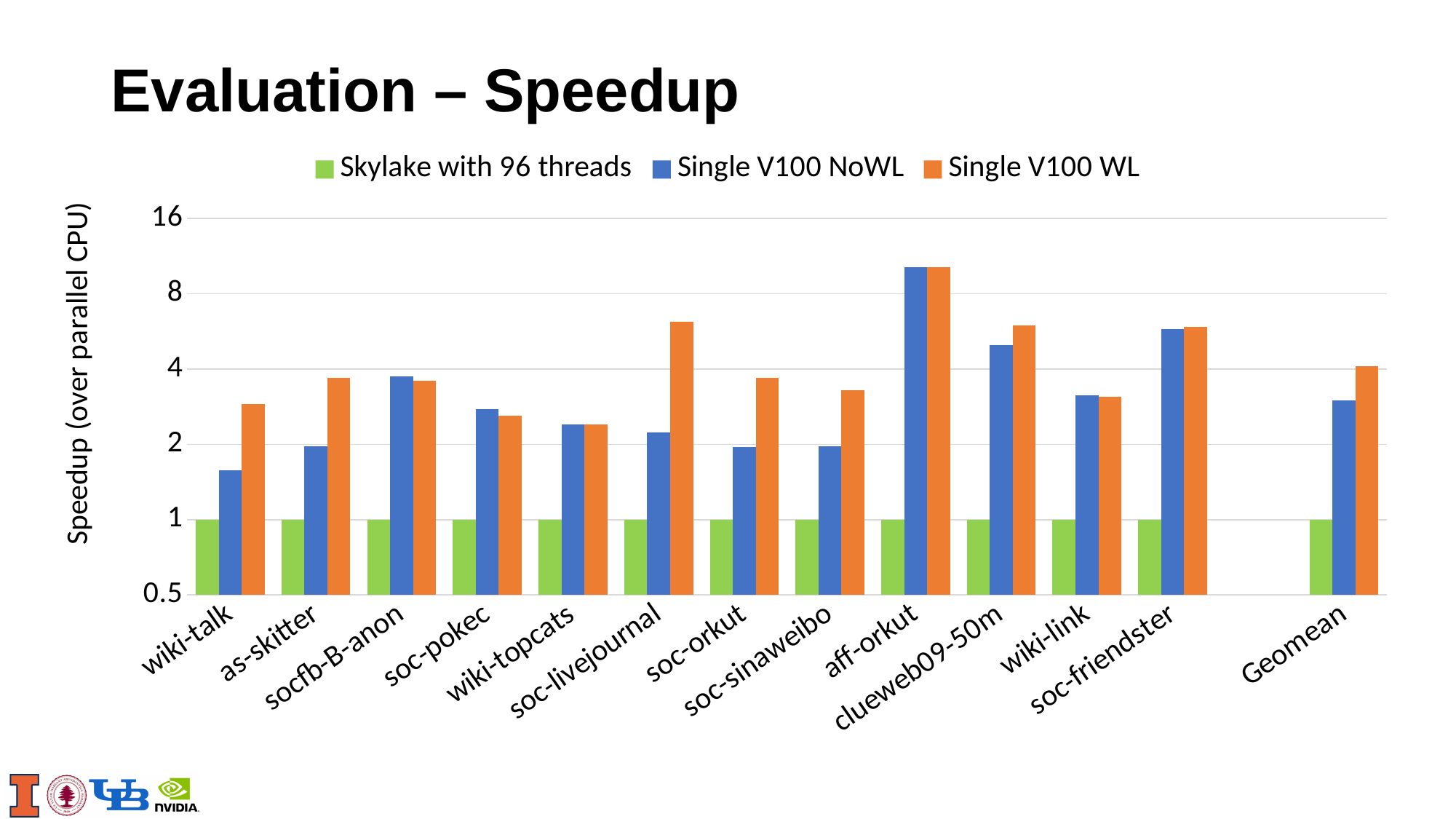
How many series does the legend list? 3 Is the value for Single V100 WL for soc-livejournal greater or less than 4? greater How many categories are shown along the x axis? 13 What is the value for Skylake with 96 threads for Geomean? 1 What kind of chart is shown on the slide? bar chart What is the title of the y axis? Speedup (over parallel CPU) Is the value for Single V100 NoWL for aff-orkut greater or less than 8? greater Is the value for Single V100 NoWL for Geomean greater or less than 4? less For soc-livejournal, which is larger: Single V100 NoWL or Single V100 WL? Single V100 WL Which category has the highest value for Single V100 WL? aff-orkut What is the value for Skylake with 96 threads for wiki-talk? 1 Which category has the lowest value for Single V100 NoWL? wiki-talk